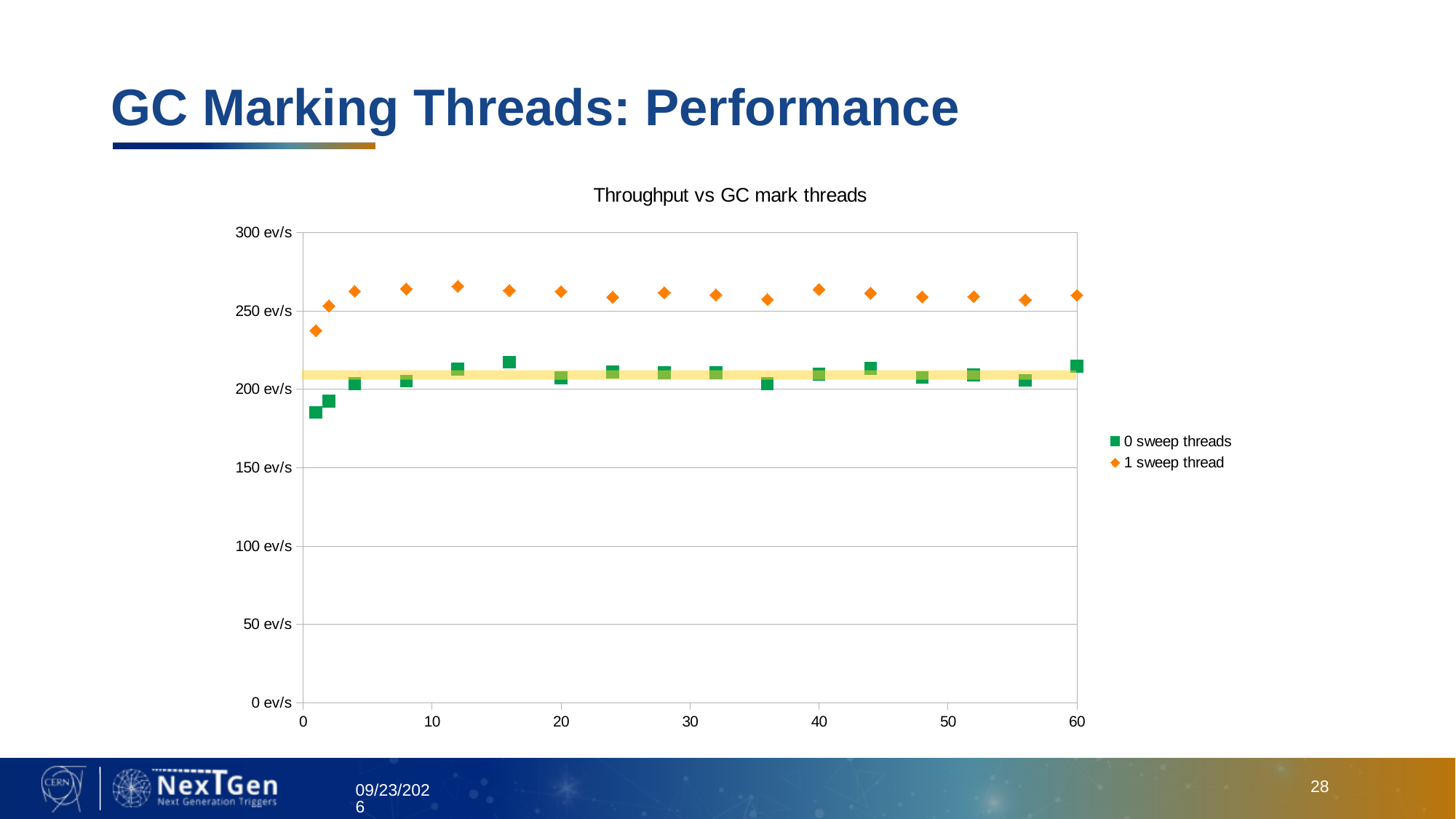
What kind of chart is shown on the slide? scatter chart What is the title of the chart? Throughput vs GC mark threads For the 1 sweep thread series, at which number of GC mark threads is the throughput lowest? 1 How many data points are plotted for the 1 sweep thread series? 17 At 40 GC mark threads, which series has the higher throughput, 0 sweep threads or 1 sweep thread? 1 sweep thread Does the throughput of the 0 sweep threads series rise or fall between 1 and 8 GC mark threads? rise How many series does the legend list? 2 Which series is drawn with orange diamond markers? 1 sweep thread Is the value for the 1 sweep thread series at 1 GC mark thread greater or less than 250 ev/s? less Is the value for the 0 sweep threads series at 1 GC mark thread greater or less than 200 ev/s? less Is the value for the 0 sweep threads series at 16 GC mark threads greater or less than 200 ev/s? greater